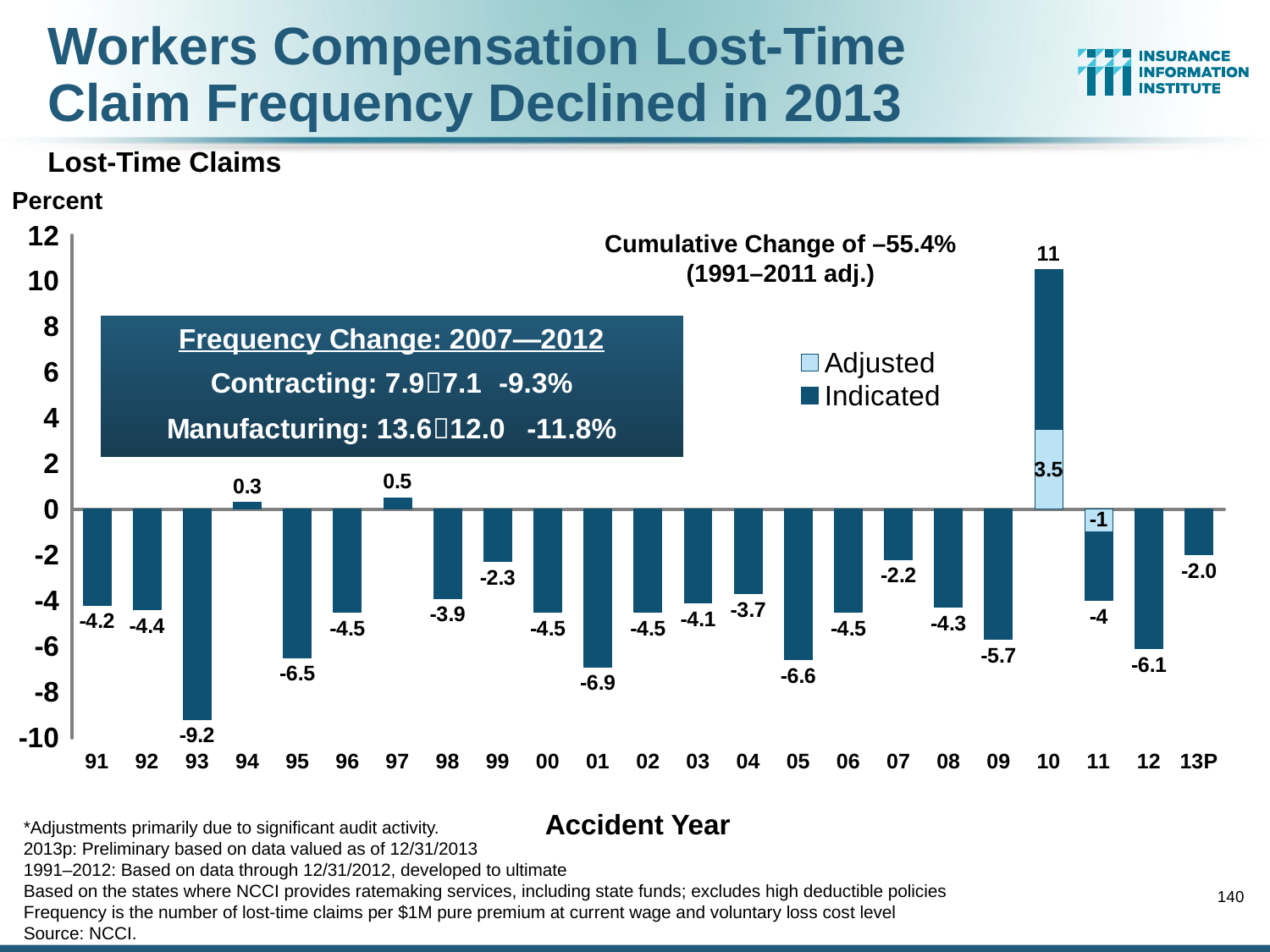
What kind of chart is shown on the slide? bar chart Which accident year has the highest value on the chart? 10 Which accident year has the larger value, 97 or 94? 97 How many series does the legend list? 2 What is the value for accident year 93? -9.2 What cumulative change is stated on the chart for 1991–2011 (adj.)? –55.4% What is the value for accident year 13P? -2.0 What is the Indicated value labeled for accident year 10? 11 Which accident year has the lowest value on the chart? 93 What is the Adjusted value shown for accident year 10? 3.5 How many accident years are shown on the x axis? 23 What is the difference between the values for accident years 01 and 05? 0.3